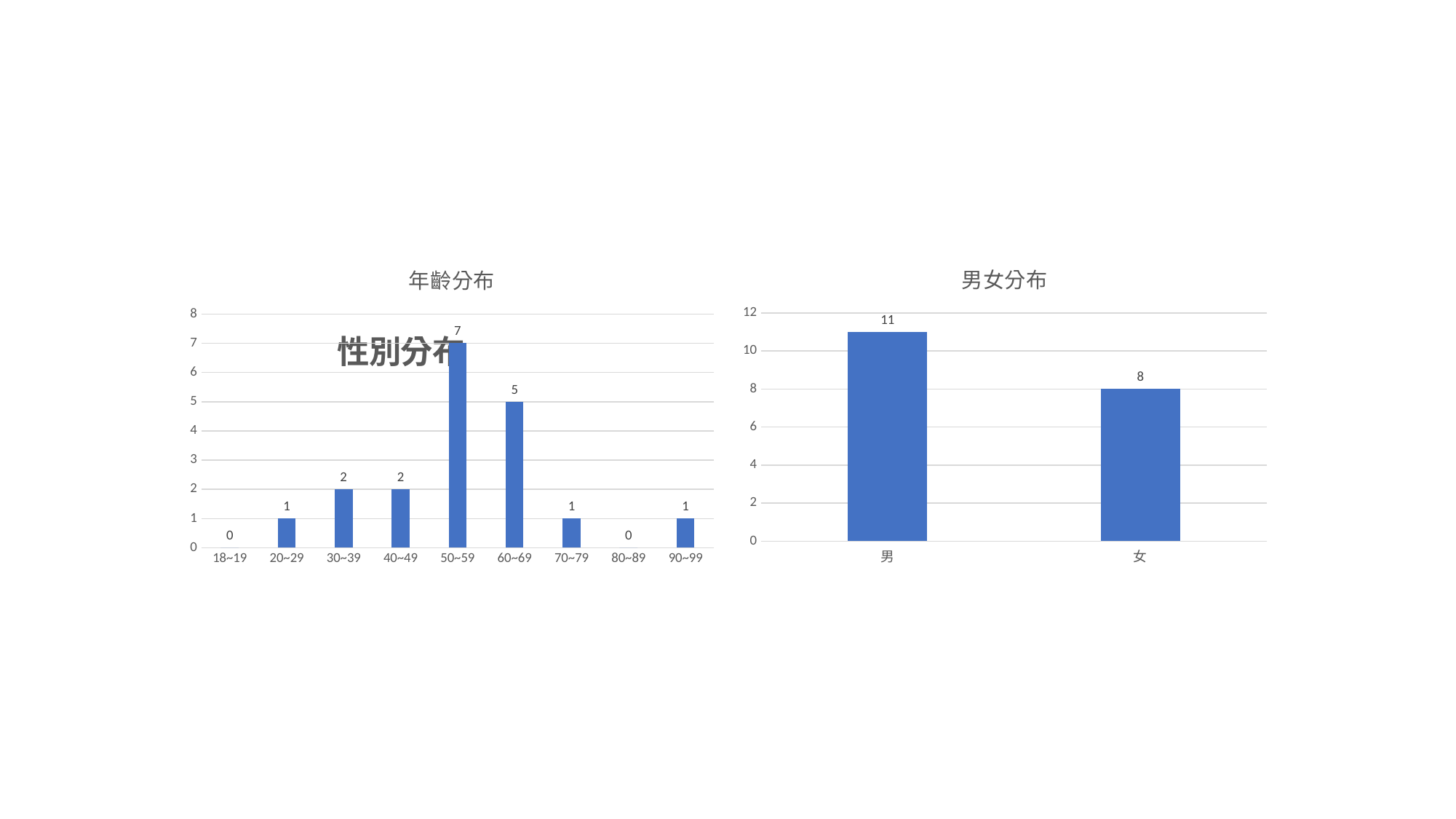
In the 年齢分布 chart, which is larger, the value for 30~39 or the value for 70~79? 30~39 In the 男女分布 chart, what is the value for 女? 8 In the 男女分布 chart, what is the difference between the values for 男 and 女? 3 In the 年齢分布 chart, what is the value for 60~69? 5 In the 年齢分布 chart, what is the value for 80~89? 0 In the 年齢分布 chart, what is the value for 50~59? 7 In the 男女分布 chart, what is the value for 男? 11 In the 男女分布 chart, is the value for 男 greater or less than 10? greater What kind of chart is the 男女分布 chart? bar chart In the 年齢分布 chart, what is the difference between the values for 50~59 and 60~69? 2 In the 年齢分布 chart, how many age group categories are shown on the x axis? 9 In the 年齢分布 chart, which age group has the highest value? 50~59